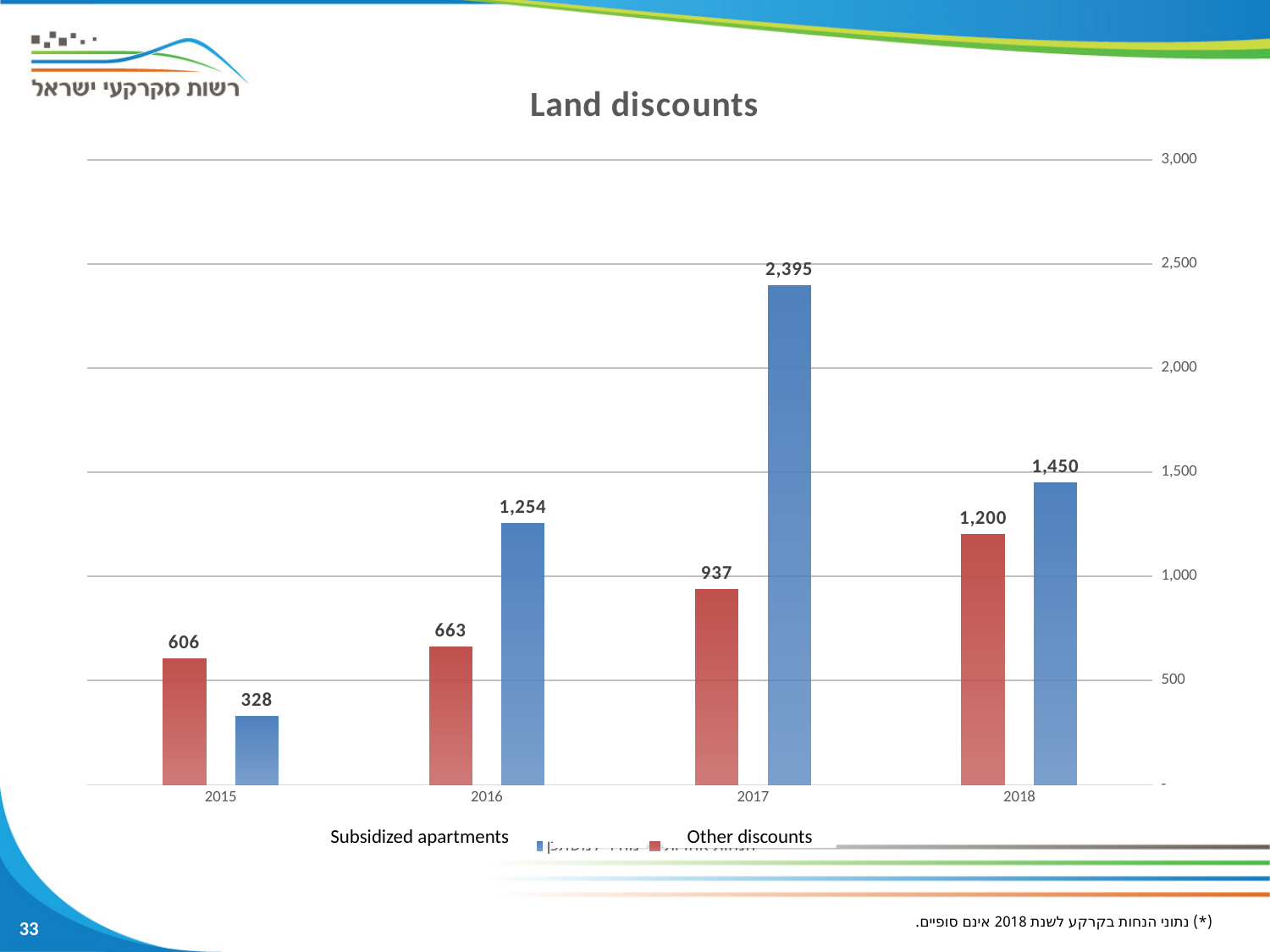
What is the value for Other discounts in 2015? 606 In which year is the Other discounts value lowest? 2015 In 2015, which is larger: Subsidized apartments or Other discounts? Other discounts How many years are shown on the x axis? 4 How many series does the legend list? 2 What kind of chart is shown on the slide? Bar chart In which year is the Subsidized apartments value highest? 2017 What is the value for Subsidized apartments in 2017? 2,395 What is the value for Subsidized apartments in 2015? 328 What is the difference between Subsidized apartments and Other discounts in 2016? 591 What is the value for Other discounts in 2018? 1,200 Do the Other discounts values rise or fall from 2015 to 2018? Rise